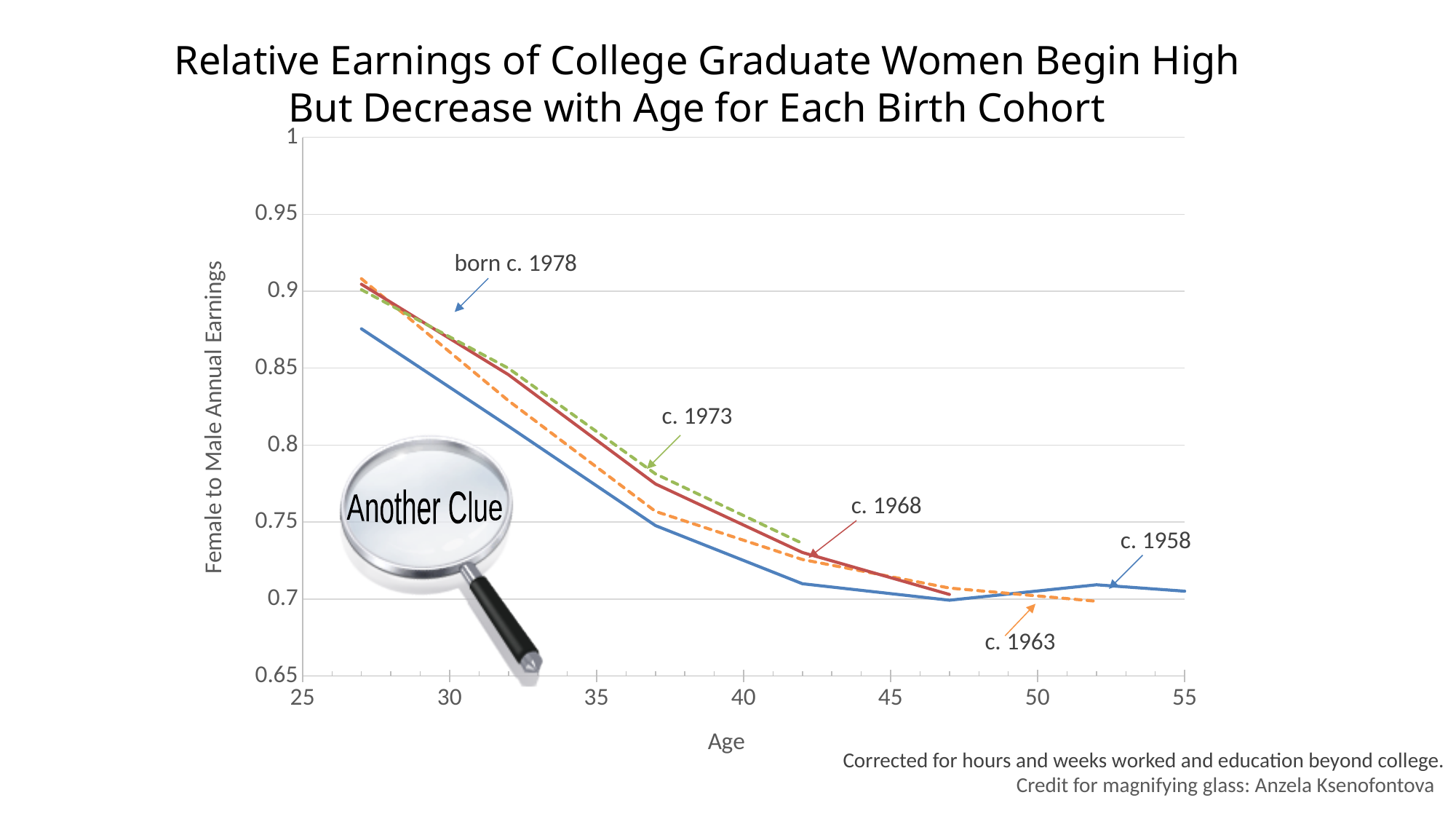
What kind of chart is shown on the slide? line chart How many birth cohorts are labelled on the chart? 5 Which cohort's line extends to the oldest age on the chart? c. 1958 Is the value for the c. 1958 cohort at age 27 greater or less than 0.9? less Is the value for the c. 1973 cohort at age 42 greater or less than 0.75? less Do the relative earnings for each cohort rise or fall as age increases? fall What is the label of the vertical axis? Female to Male Annual Earnings At age 27, which cohort has the higher relative earnings, c. 1958 or c. 1968? c. 1968 Is the value for the c. 1968 cohort at age 27 greater or less than 0.9? greater What is the title of the chart? Relative Earnings of College Graduate Women Begin High But Decrease with Age for Each Birth Cohort At age 37, which cohort has the higher relative earnings, c. 1958 or c. 1973? c. 1973